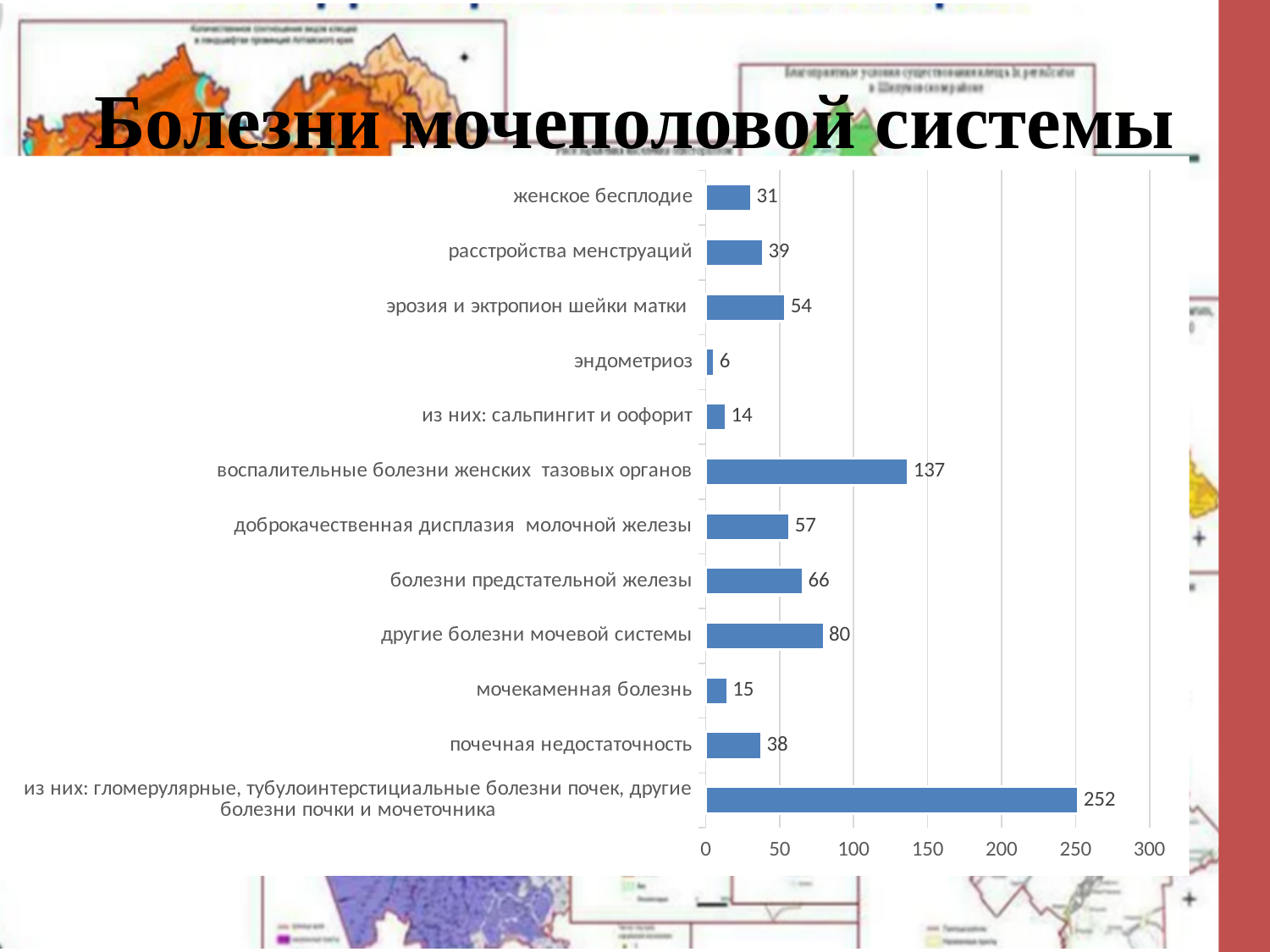
What is the value for мочекаменная болезнь? 15 Which is larger: the value for эрозия и эктропион шейки матки or the value for расстройства менструаций? эрозия и эктропион шейки матки Which category has the highest value? из них: гломерулярные, тубулоинтерстициальные болезни почек, другие болезни почки и мочеточника Which category has the lowest value? эндометриоз What is the difference between the values for другие болезни мочевой системы and болезни предстательной железы? 14 What is the title of the slide? Болезни мочеполовой системы What is the maximum value shown on the horizontal axis? 300 Is the value for доброкачественная дисплазия молочной железы greater or less than 50? greater What is the value for воспалительные болезни женских тазовых органов? 137 What kind of chart is shown on the slide? bar chart What is the value for женское бесплодие? 31 How many categories are shown in the chart? 12